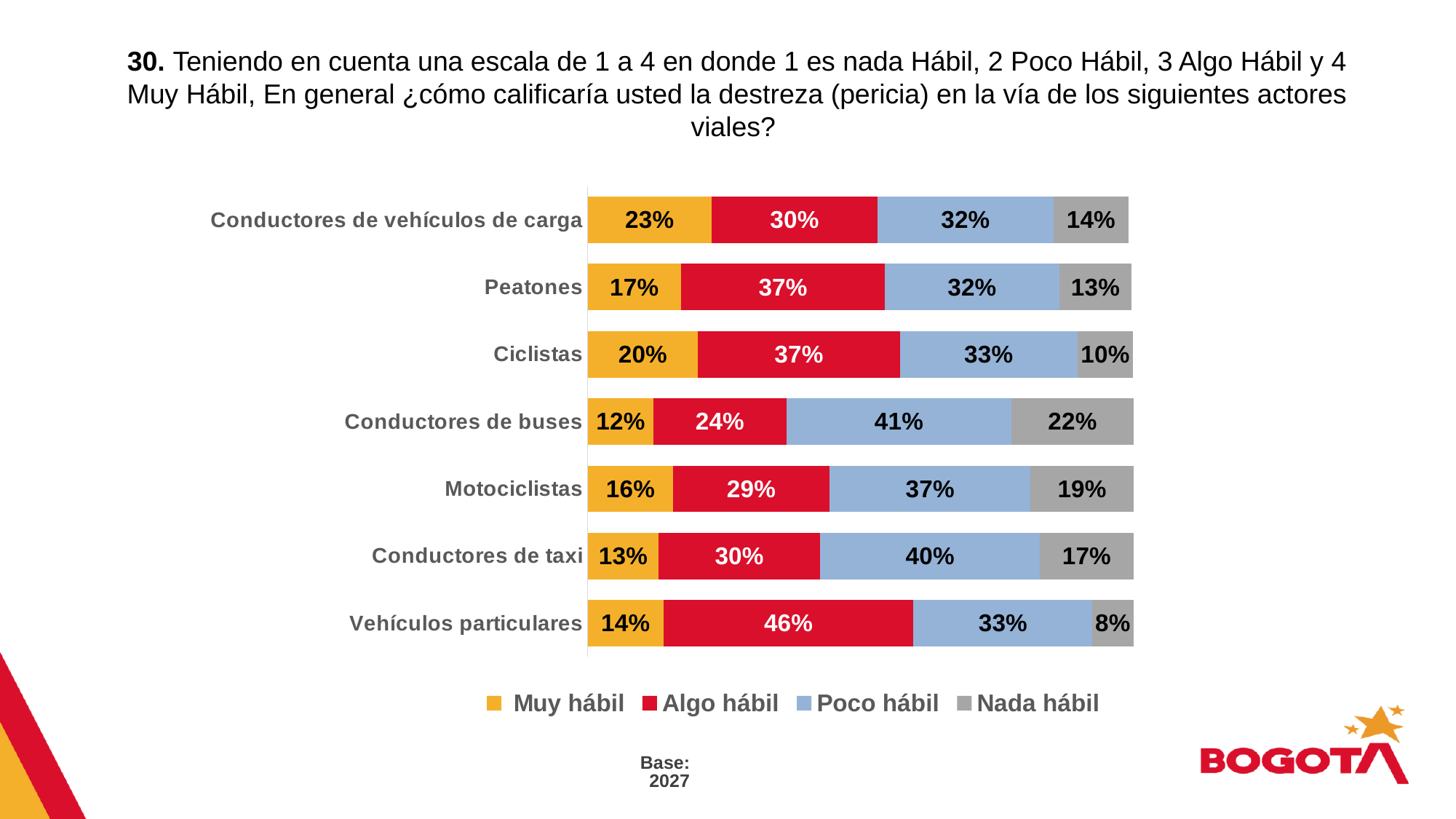
How many percentage points higher is the "Poco hábil" value for Conductores de taxi than for Peatones? 8 What is the "Nada hábil" value for Motociclistas? 19% What is the "Algo hábil" value for Vehículos particulares? 46% Which category has the highest "Algo hábil" value? Vehículos particulares What kind of chart is shown on the slide? Stacked bar chart How many series does the legend list? 4 Which category has the lowest "Nada hábil" value? Vehículos particulares Which category has the highest "Muy hábil" value? Conductores de vehículos de carga What percentage of respondents rated Conductores de vehículos de carga as "Muy hábil"? 23% How many categories (road actors) are shown in the chart? 7 Which has a larger "Nada hábil" value, Conductores de buses or Conductores de taxi? Conductores de buses What is the "Poco hábil" value for Conductores de buses? 41%